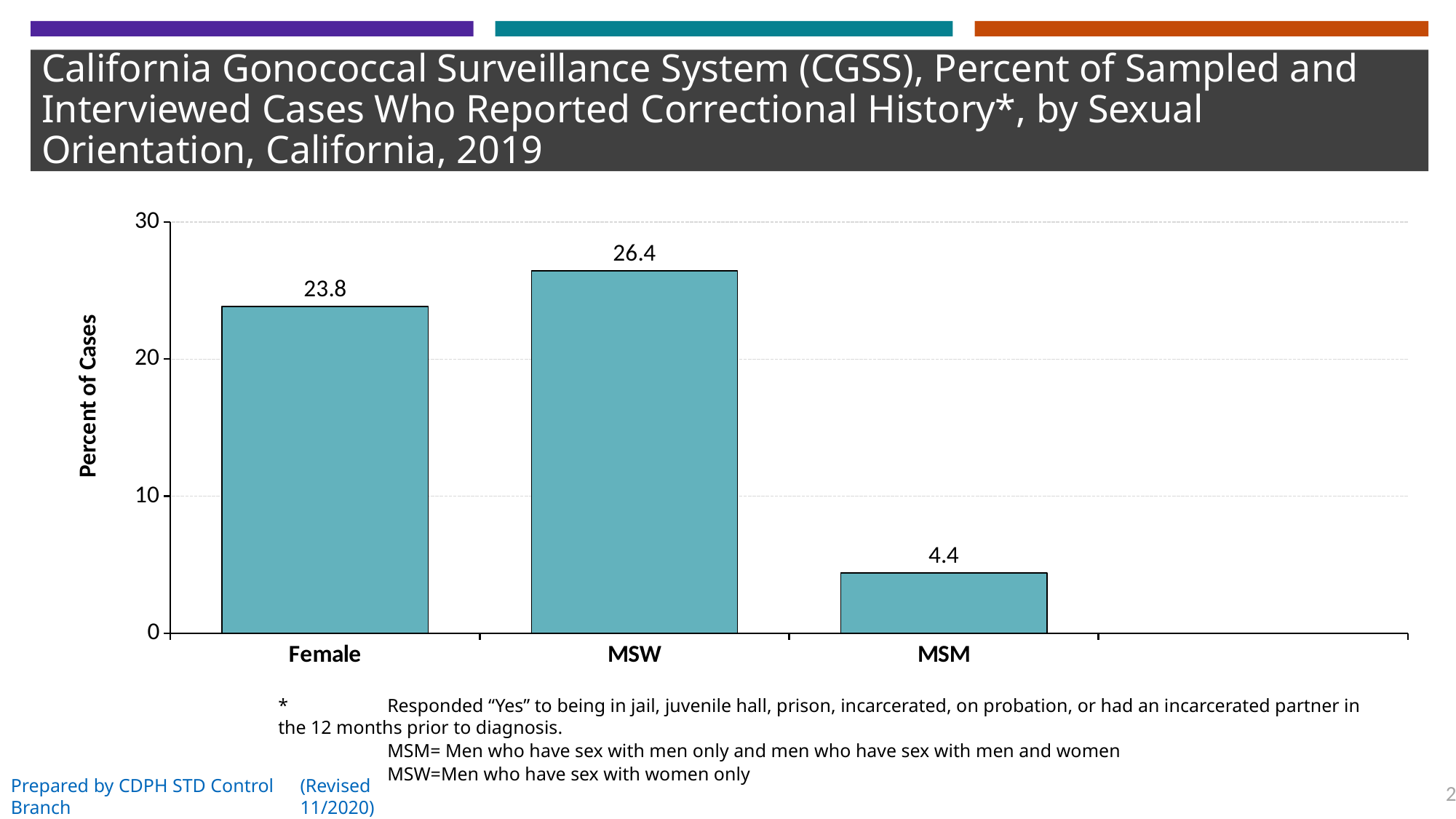
Which category has the lowest percent of cases? MSM What is the label of the y axis? Percent of Cases Is the value for MSM greater or less than 10? less What is the percent of cases for MSM? 4.4 What is the percent of cases for Female? 23.8 How many categories are shown on the x axis? 3 Which category has the highest percent of cases? MSW What is the percent of cases for MSW? 26.4 Which is larger, the value for Female or the value for MSM? Female What is the difference between the values for Female and MSM? 19.4 What kind of chart is shown on the slide? bar chart What is the difference between the values for MSW and Female? 2.6